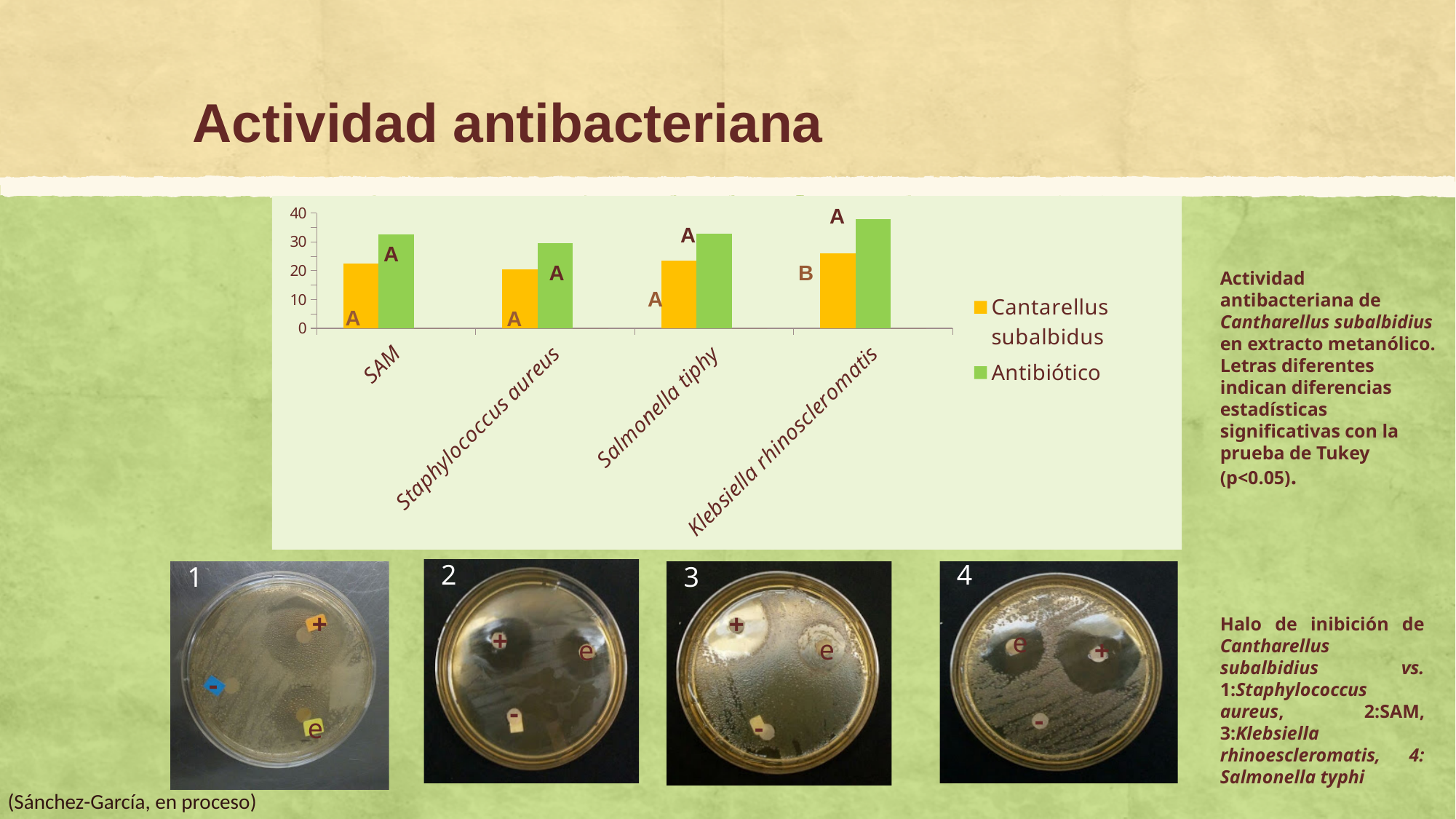
How many series does the chart legend list? 2 For which category is the Antibiótico bar the highest? Klebsiella rhinoscleromatis For Klebsiella rhinoscleromatis, which is larger: the Cantarellus subalbidus bar or the Antibiótico bar? Antibiótico For which category is the Antibiótico bar the lowest? Staphylococcus aureus Is the Antibiótico value for Klebsiella rhinoscleromatis greater or less than 30? greater Is the Cantarellus subalbidus value for Staphylococcus aureus greater or less than 30? less How many bacterial categories are shown on the x axis of the chart? 4 Is the Cantarellus subalbidus value for SAM greater or less than 10? greater Which series is shown in yellow/orange in the chart? Cantarellus subalbidus For SAM, which is larger: the Cantarellus subalbidus bar or the Antibiótico bar? Antibiótico What kind of chart is shown on the slide? bar chart Which series is shown in green in the chart? Antibiótico